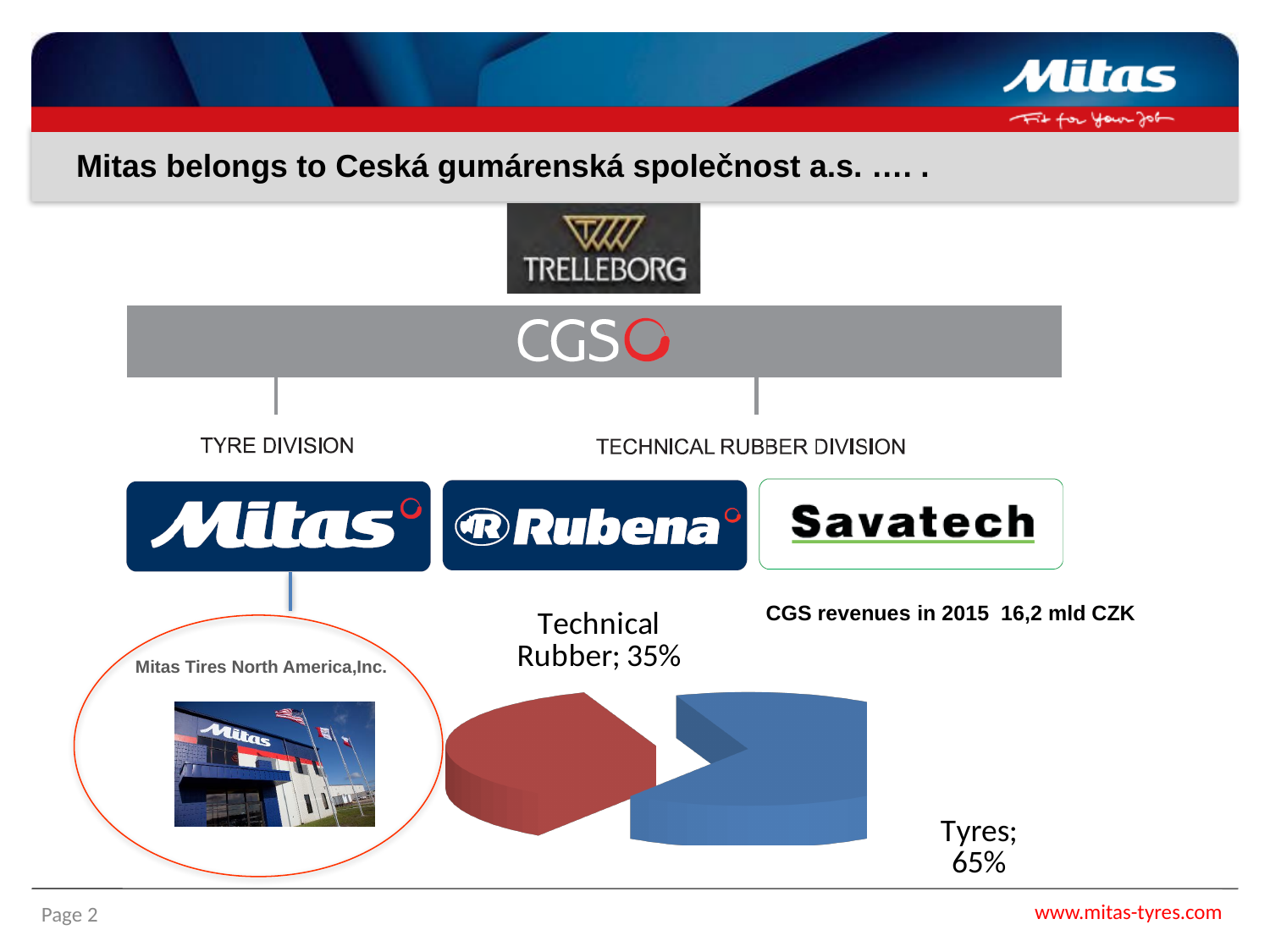
How many slices does the pie chart have? 2 What colour is the Tyres slice of the pie chart? blue What total CGS revenue figure for 2015 is stated next to the pie chart? 16,2 mld CZK What is the difference in percentage points between the Tyres and Technical Rubber shares? 30 What kind of chart is shown at the bottom of the slide? pie chart What share of CGS revenues comes from Tyres? 65% Which slice of the pie chart is the smallest? Technical Rubber Is the Technical Rubber share greater or less than 50%? less Which slice of the pie chart is the largest? Tyres What share of CGS revenues comes from Technical Rubber? 35% Which is larger, the Tyres share or the Technical Rubber share? Tyres